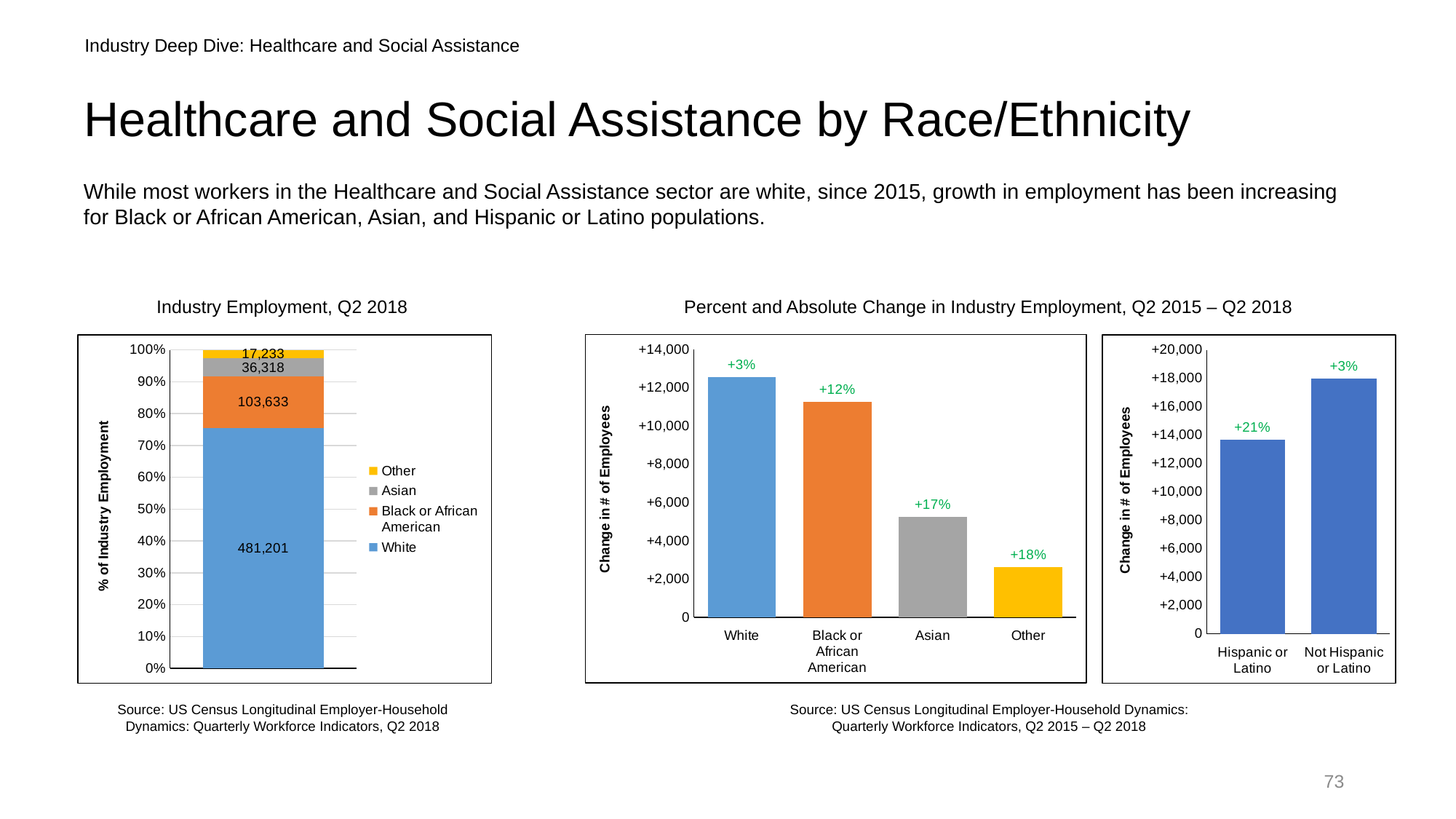
In the middle chart (Percent and Absolute Change in Industry Employment by race), which category has the largest change in number of employees? White In the Industry Employment, Q2 2018 chart, what is the difference between the White and Black or African American values? 377,568 In the right chart (change in employment by Hispanic or Latino status), is the value for Not Hispanic or Latino greater or less than 16,000? greater In the Industry Employment, Q2 2018 chart, what is the total of the stacked bar? 638,385 In the Industry Employment, Q2 2018 chart, what is the value shown for White? 481,201 In the middle chart (Percent and Absolute Change in Industry Employment by race), which category has the smallest change in number of employees? Other In the middle chart (Percent and Absolute Change in Industry Employment by race), what percent change is shown for Asian? +17% In the Industry Employment, Q2 2018 chart, how many series does the legend list? 4 In the Industry Employment, Q2 2018 chart, what is the value shown for Asian? 36,318 In the Industry Employment, Q2 2018 chart, what is the value shown for Black or African American? 103,633 In the middle chart (Percent and Absolute Change in Industry Employment by race), is the value for Asian greater or less than 6,000? less In the right chart (change in employment by Hispanic or Latino status), what percent change is shown for Hispanic or Latino? +21%